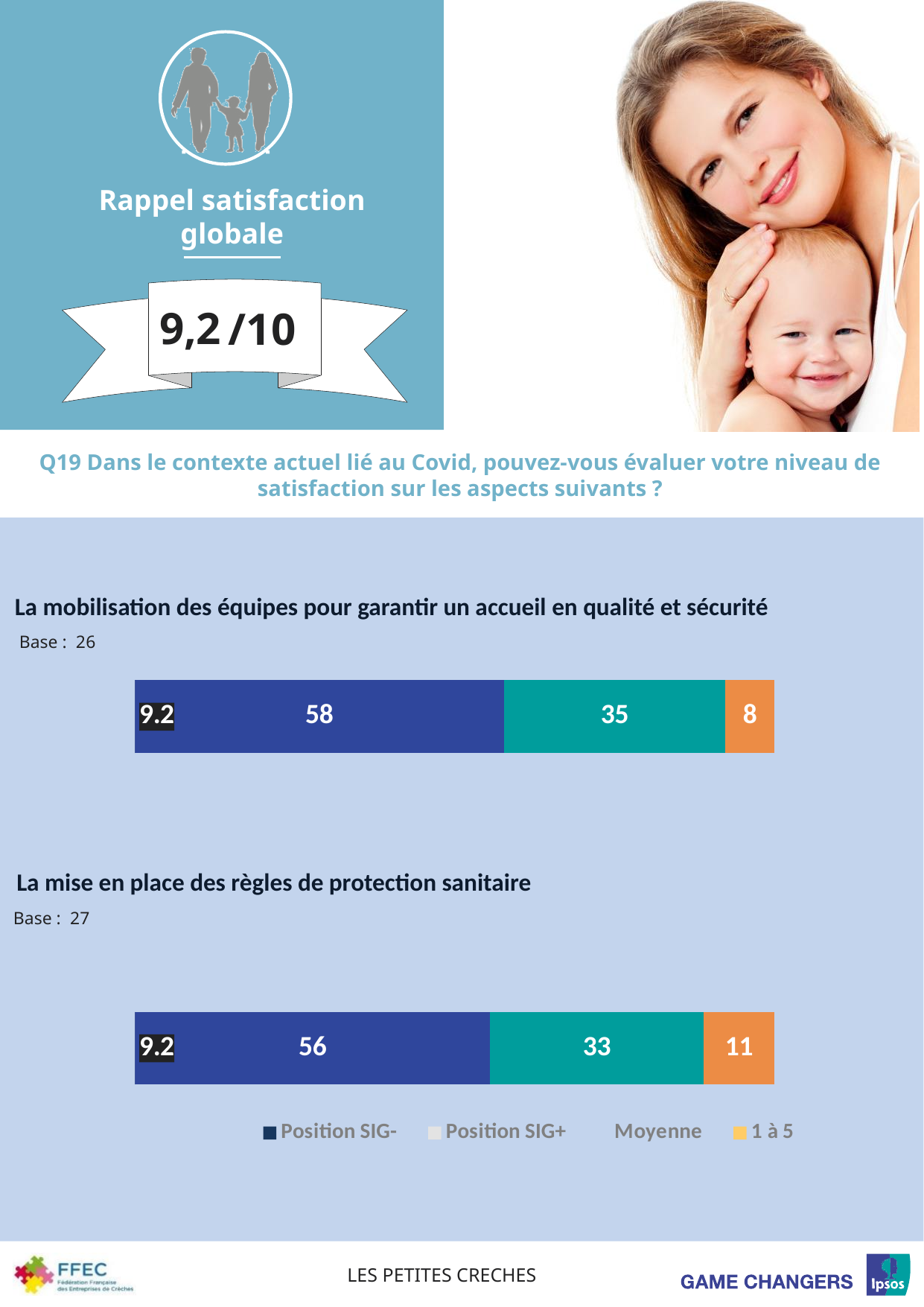
How many entries does the legend below the charts list? 4 In the chart 'La mobilisation des équipes pour garantir un accueil en qualité et sécurité', which segment has the smallest value? The orange segment (8) In the chart 'La mobilisation des équipes pour garantir un accueil en qualité et sécurité', what value is shown in the teal segment? 35 In the chart 'La mise en place des règles de protection sanitaire', what value is shown in the dark blue segment? 56 What kind of chart is used to show the satisfaction results for 'La mobilisation des équipes pour garantir un accueil en qualité et sécurité'? Stacked bar chart In the chart 'La mise en place des règles de protection sanitaire', which segment has the largest value? The dark blue segment (56) In the chart 'La mobilisation des équipes pour garantir un accueil en qualité et sécurité', what value is shown in the dark blue segment? 58 In the chart 'La mise en place des règles de protection sanitaire', what value is shown in the orange segment? 11 What mean score is displayed in the black box at the left of the bar in the chart 'La mise en place des règles de protection sanitaire'? 9.2 What is the difference between the dark blue segment values of the two charts (58 in the first chart and 56 in the second)? 2 In the chart 'La mobilisation des équipes pour garantir un accueil en qualité et sécurité', what value is shown in the orange segment? 8 Which chart has the larger orange segment value: 'La mobilisation des équipes...' or 'La mise en place des règles de protection sanitaire'? La mise en place des règles de protection sanitaire